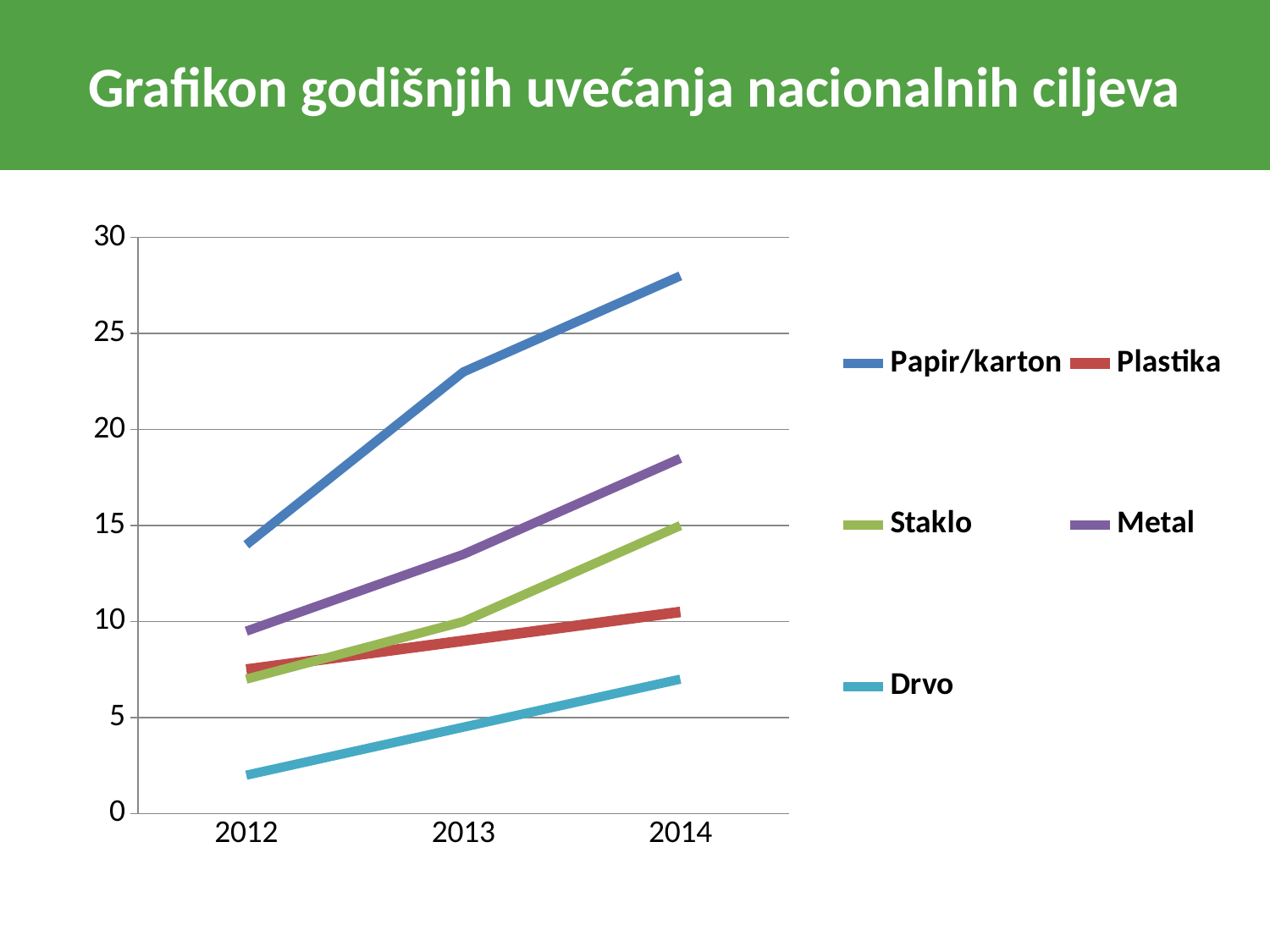
Is the value for Drvo in 2012 greater or less than 5? less Is the value for Drvo in 2014 greater or less than 5? greater How many years are shown on the x axis? 3 Is the value for Papir/karton in 2013 greater or less than 20? greater Which series has the lowest value in 2012? Drvo Does the Papir/karton line rise or fall from 2012 to 2014? rise What is the title of the slide containing the chart? Grafikon godišnjih uvećanja nacionalnih ciljeva Which series has the highest value in 2014? Papir/karton How many series does the legend list? 5 What kind of chart is shown on the slide? line chart Which is larger in 2014, the value for Metal or the value for Staklo? Metal